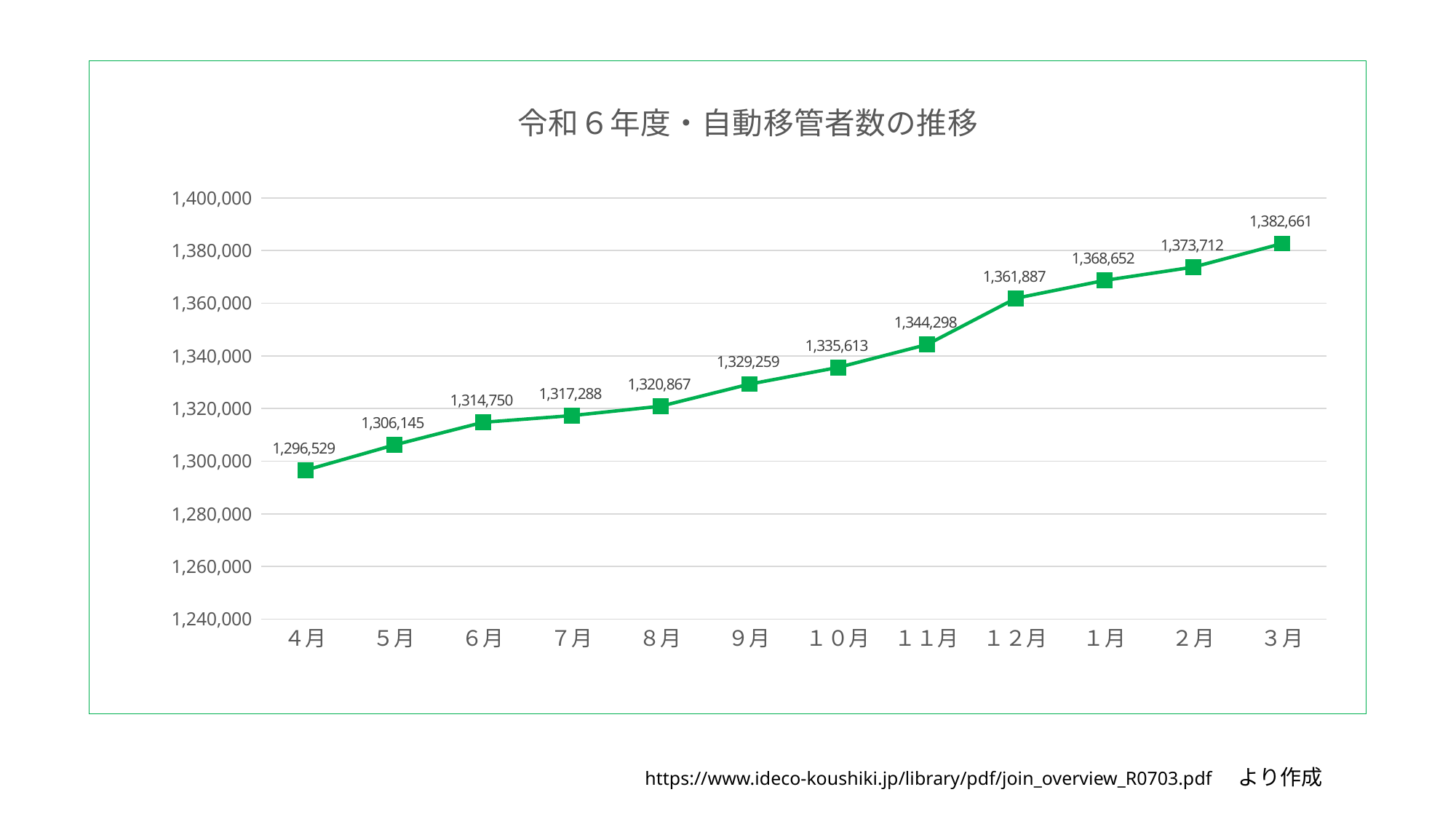
What is the difference between the values for 3月 and 4月? 86,132 What is the difference between the values for 12月 and 11月? 17,589 Which month has the lowest value? 4月 Which is larger, the value for 9月 or the value for 1月? 1月 Do the values rise or fall from 4月 to 3月? rise What kind of chart is shown? line chart How many months are plotted on the chart? 12 Which month has the highest value? 3月 What is the value for 3月? 1,382,661 What is the value for 4月? 1,296,529 What is the value for 10月? 1,335,613 Is the value for 12月 greater or less than 1,360,000? greater